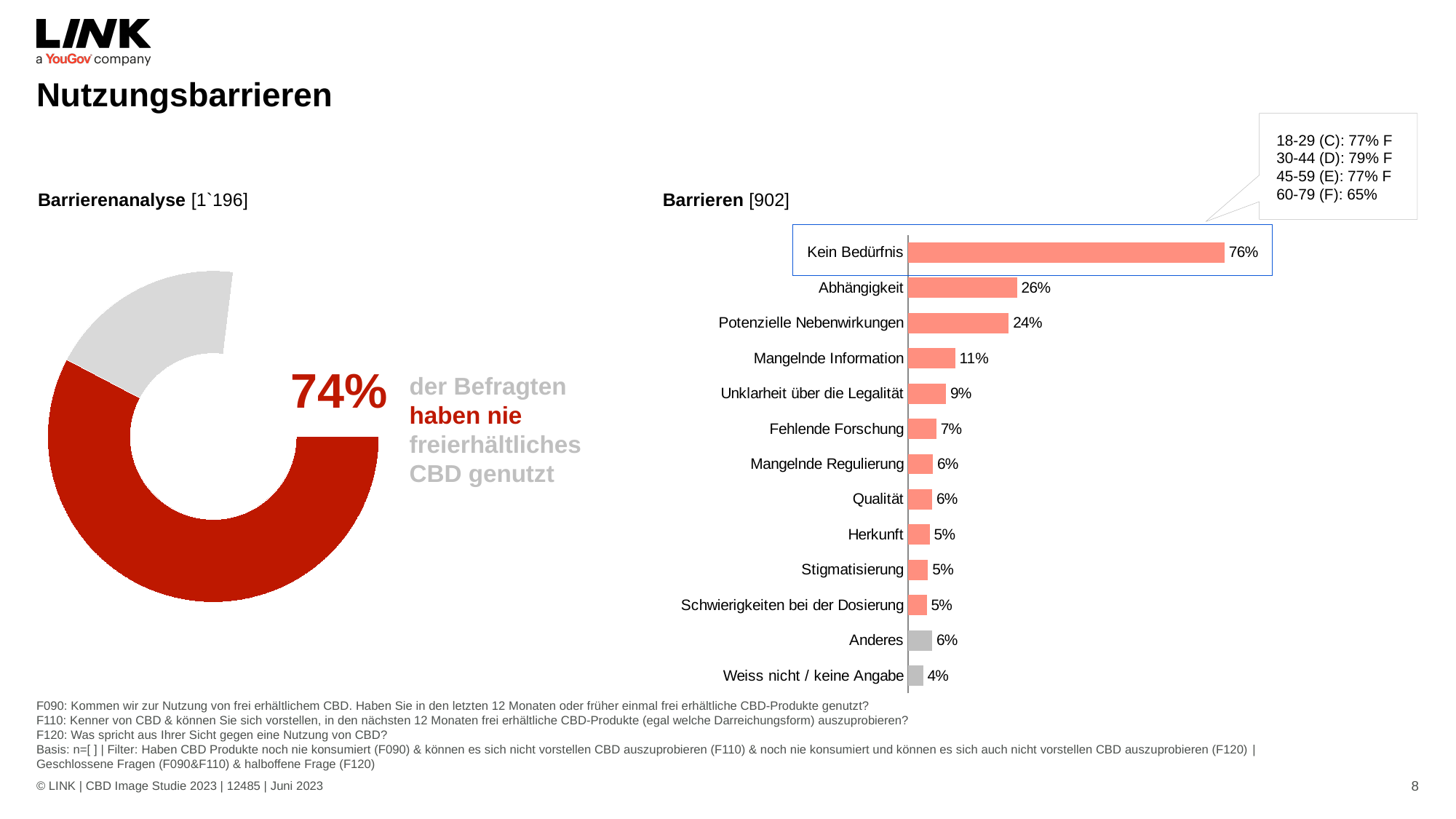
In the 'Barrieren' bar chart, which category has the highest value? Kein Bedürfnis In the 'Barrieren' bar chart, which category has the lowest value? Weiss nicht / keine Angabe What kind of chart is the 'Barrierenanalyse' chart on the left? Donut chart What kind of chart is the 'Barrieren' chart on the right? Bar chart In the 'Barrieren' bar chart, which is larger: 'Mangelnde Information' or 'Fehlende Forschung'? Mangelnde Information In the 'Barrieren' bar chart, what is the difference between 'Abhängigkeit' and 'Potenzielle Nebenwirkungen'? 2% In the 'Barrierenanalyse' chart, what percentage of respondents have never used freely available CBD? 74% In the 'Barrieren' bar chart, what is the value for 'Potenzielle Nebenwirkungen'? 24% How many categories are shown in the 'Barrieren' bar chart? 13 In the 'Barrieren' bar chart, what is the value for 'Anderes'? 6% In the 'Barrieren' bar chart, what is the value for 'Kein Bedürfnis'? 76% In the 'Barrieren' bar chart, what is the value for 'Unklarheit über die Legalität'? 9%